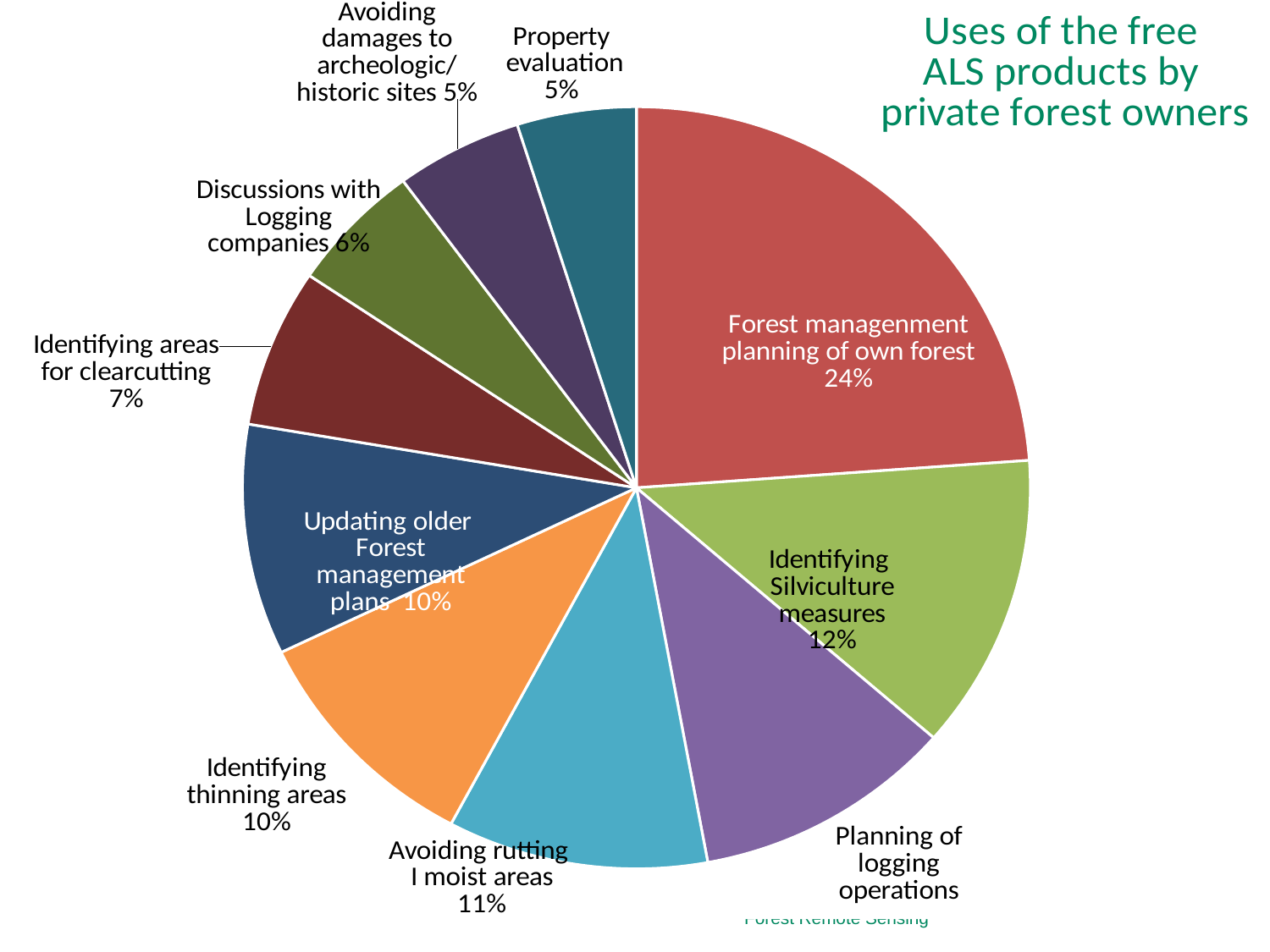
What share of the pie does 'Identifying Silviculture measures' represent? 12% What is the difference between 'Forest management planning of own forest' and 'Identifying Silviculture measures'? 12% What percentage is shown for 'Property evaluation'? 5% What is the title of the chart? Uses of the free ALS products by private forest owners What type of chart is shown on the slide? Pie chart Which is larger, 'Identifying thinning areas' or 'Identifying areas for clearcutting'? Identifying thinning areas What percentage is shown for 'Identifying areas for clearcutting'? 7% What is the value shown for 'Avoiding rutting I moist areas'? 11% How many slices does the pie chart have? 10 What percentage of the pie is 'Forest management planning of own forest'? 24% What is the value for 'Discussions with Logging companies'? 6% Which category has the largest slice of the pie? Forest management planning of own forest